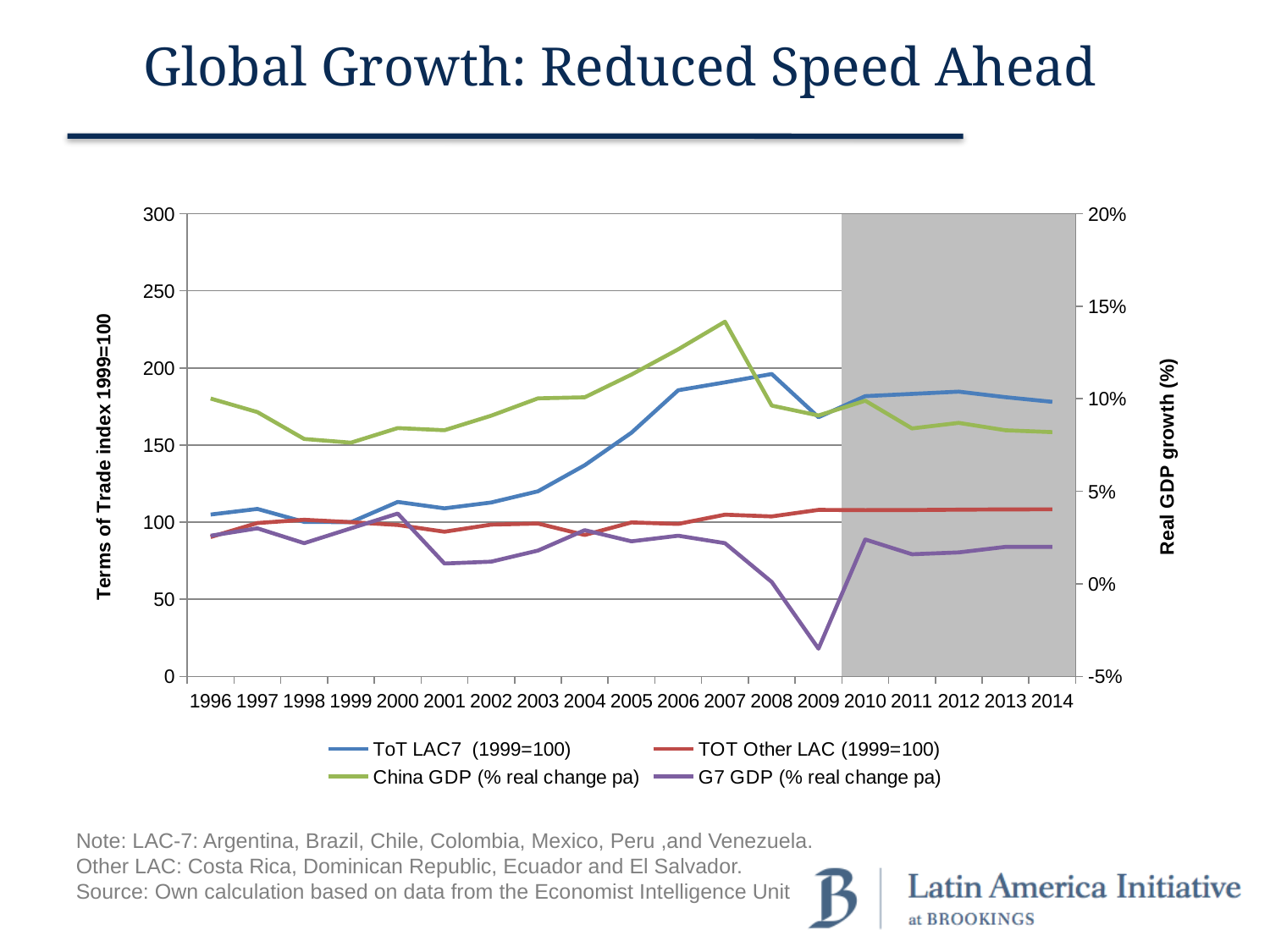
What is the label of the right-hand vertical axis? Real GDP growth (%) Is the value for China GDP (% real change pa) in 2007 greater or less than 10%? greater What is the value of ToT LAC7 (1999=100) in 1999? 100 How many series does the legend list? 4 What kind of chart is shown on the slide? Line chart Is the value for ToT LAC7 (1999=100) in 2008 greater or less than 150? greater Is the value for G7 GDP (% real change pa) in 2009 greater or less than 0%? less In which year does G7 GDP (% real change pa) reach its lowest value? 2009 In 2008, which is larger: ToT LAC7 (1999=100) or TOT Other LAC (1999=100)? ToT LAC7 (1999=100) In which year does ToT LAC7 (1999=100) reach its highest value? 2008 In which year does China GDP (% real change pa) reach its highest value? 2007 How many years are shown along the x axis? 19